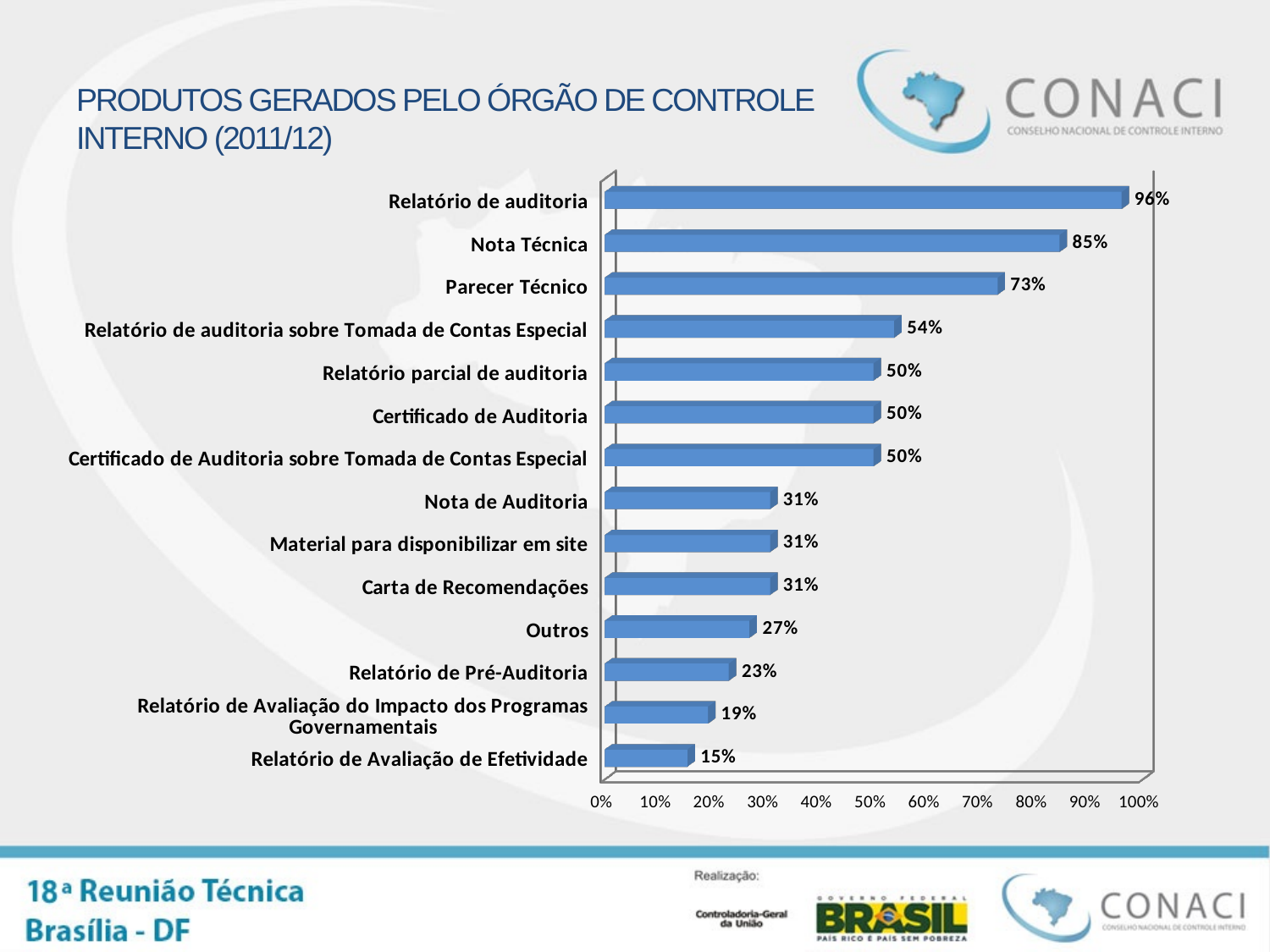
Which is larger, the value for Relatório de Pré-Auditoria or the value for Relatório de Avaliação do Impacto dos Programas Governamentais? Relatório de Pré-Auditoria What is the value for Relatório de auditoria? 96% What is the value for Outros? 27% What is the difference between the values for Nota Técnica and Parecer Técnico? 12% What is the title of the slide containing the chart? PRODUTOS GERADOS PELO ÓRGÃO DE CONTROLE INTERNO (2011/12) Which category has the highest value? Relatório de auditoria Is the value for Relatório de auditoria sobre Tomada de Contas Especial greater or less than 40%? greater What kind of chart is shown on the slide? bar chart What is the value for Parecer Técnico? 73% How many categories are shown in the chart? 14 What is the value for Relatório de Avaliação de Efetividade? 15% Which category has the lowest value? Relatório de Avaliação de Efetividade